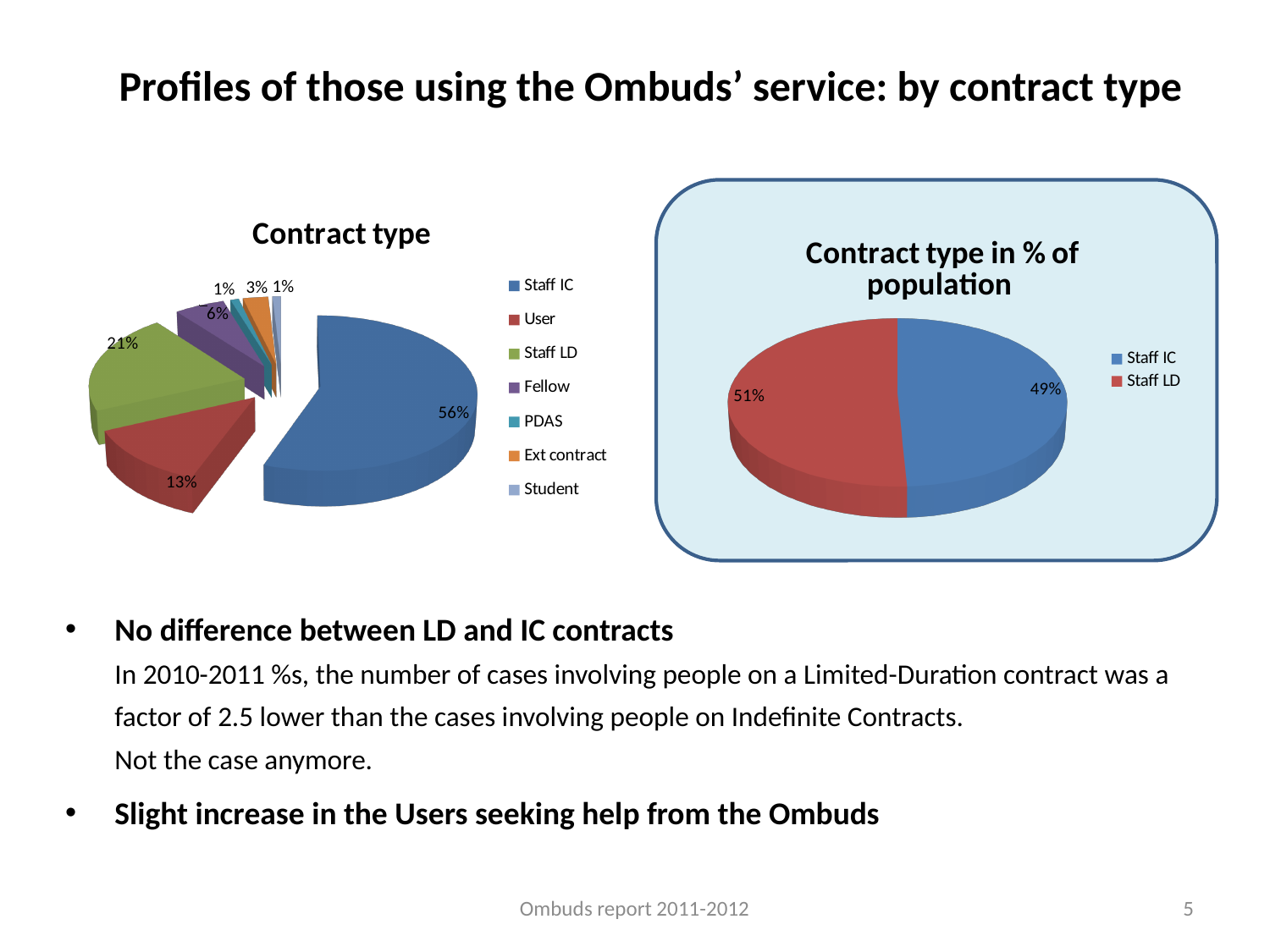
How many categories does the legend of the 'Contract type' chart list? 7 In the 'Contract type' chart, what percentage is shown for Staff LD? 21% In the 'Contract type' chart, what is the difference in percentage points between Staff IC and Staff LD? 35 How many categories does the legend of the 'Contract type in % of population' chart list? 2 What kind of chart is the 'Contract type in % of population' chart? Pie chart In the 'Contract type in % of population' chart, what percentage is shown for Staff IC? 49% In the 'Contract type' chart, what percentage is shown for Fellow? 6% In the 'Contract type' chart, which category has the largest share? Staff IC In the 'Contract type in % of population' chart, what percentage is shown for Staff LD? 51% In the 'Contract type' chart, which is larger, the share for User or the share for Fellow? User In the 'Contract type' chart, what percentage is shown for User? 13% In the 'Contract type' chart, what percentage is shown for Staff IC? 56%